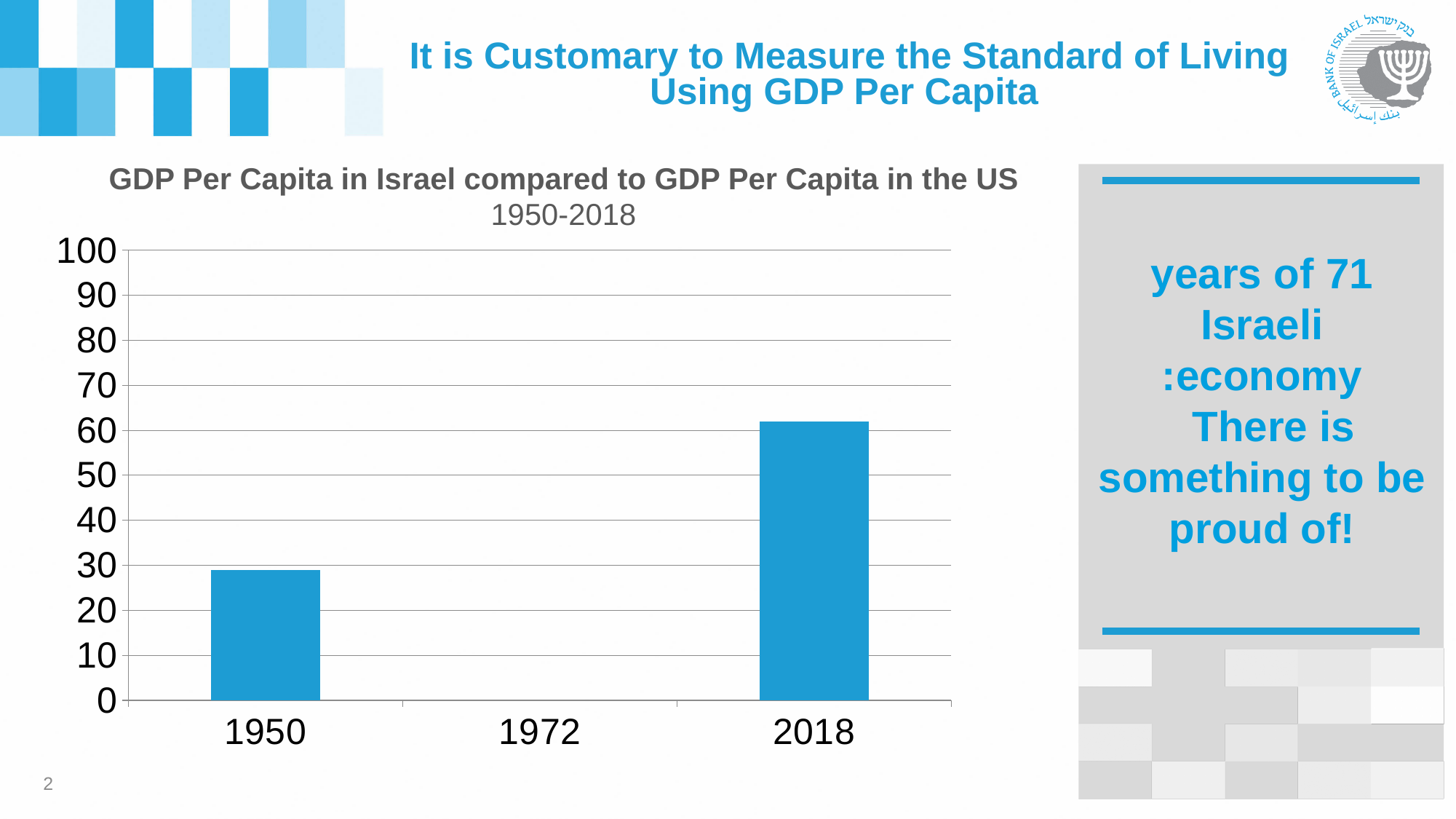
Is the value for 2018 greater or less than 70? less Which year has the tallest bar in the chart? 2018 How many year labels appear on the x axis of the chart? 3 Is the value for 2018 greater or less than 50? greater What kind of chart is shown on the slide? Bar chart Is the value for 1950 greater or less than 20? greater What period does the chart's subtitle give? 1950-2018 Which of the plotted bars is the shortest? 1950 Does the value rise or fall from 1950 to 2018? Rise Which is larger, the value for 1950 or the value for 2018? 2018 What is the title of the chart? GDP Per Capita in Israel compared to GDP Per Capita in the US